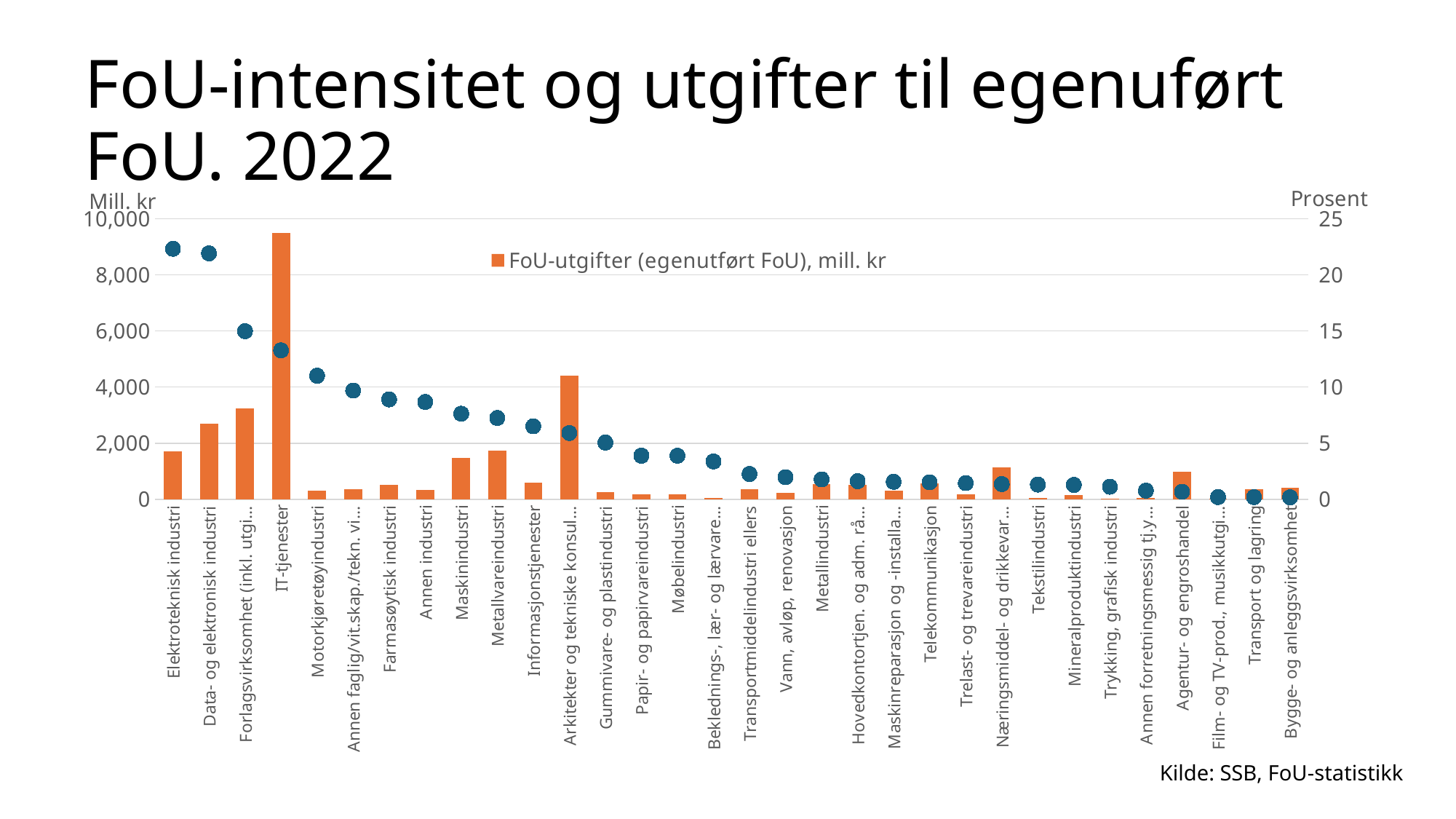
Which has the larger FoU-utgifter bar, IT-tjenester or Arkitekter og tekniske konsul...? IT-tjenester Which has the larger FoU-utgifter bar, Forlagsvirksomhet (inkl. utgi... or Data- og elektronisk industri? Forlagsvirksomhet (inkl. utgi... Is the FoU-utgifter bar for Elektroteknisk industri greater or less than 2,000 mill. kr? less Which category has the tallest bar for FoU-utgifter (egenutført FoU), mill. kr? IT-tjenester Is the FoU-utgifter bar for IT-tjenester greater or less than 8,000 mill. kr? greater What is the label of the right-hand vertical axis? Prosent Is the FoU-utgifter bar for Data- og elektronisk industri greater or less than 2,000 mill. kr? greater Do the Prosent dots generally rise or fall from left to right along the x axis? fall How many categories are shown on the x axis? 32